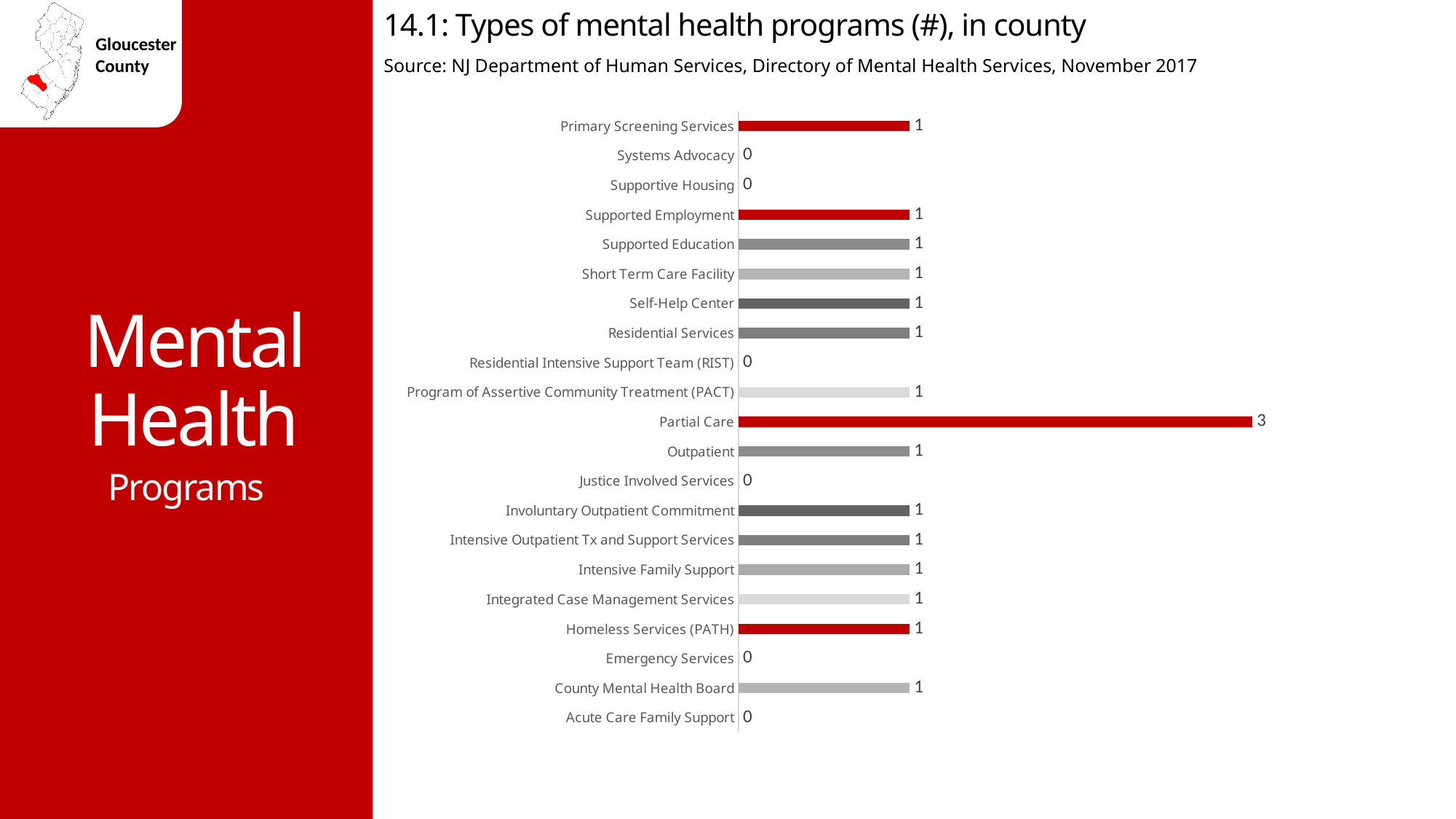
How many program types have a value of 0? 6 What is the value for Homeless Services (PATH)? 1 How many program types are listed on the chart? 21 What is the title of the chart? 14.1: Types of mental health programs (#), in county What is the source cited for the chart data? NJ Department of Human Services, Directory of Mental Health Services, November 2017 Which is larger, the value for Supported Employment or the value for Supportive Housing? Supported Employment What is the value for Residential Intensive Support Team (RIST)? 0 What is the difference between the number of Partial Care programs and the number of Outpatient programs? 2 What is the value for Emergency Services? 0 Which program type has the highest number of programs? Partial Care What type of chart is shown on the slide? bar chart How many Partial Care programs are there in the county? 3